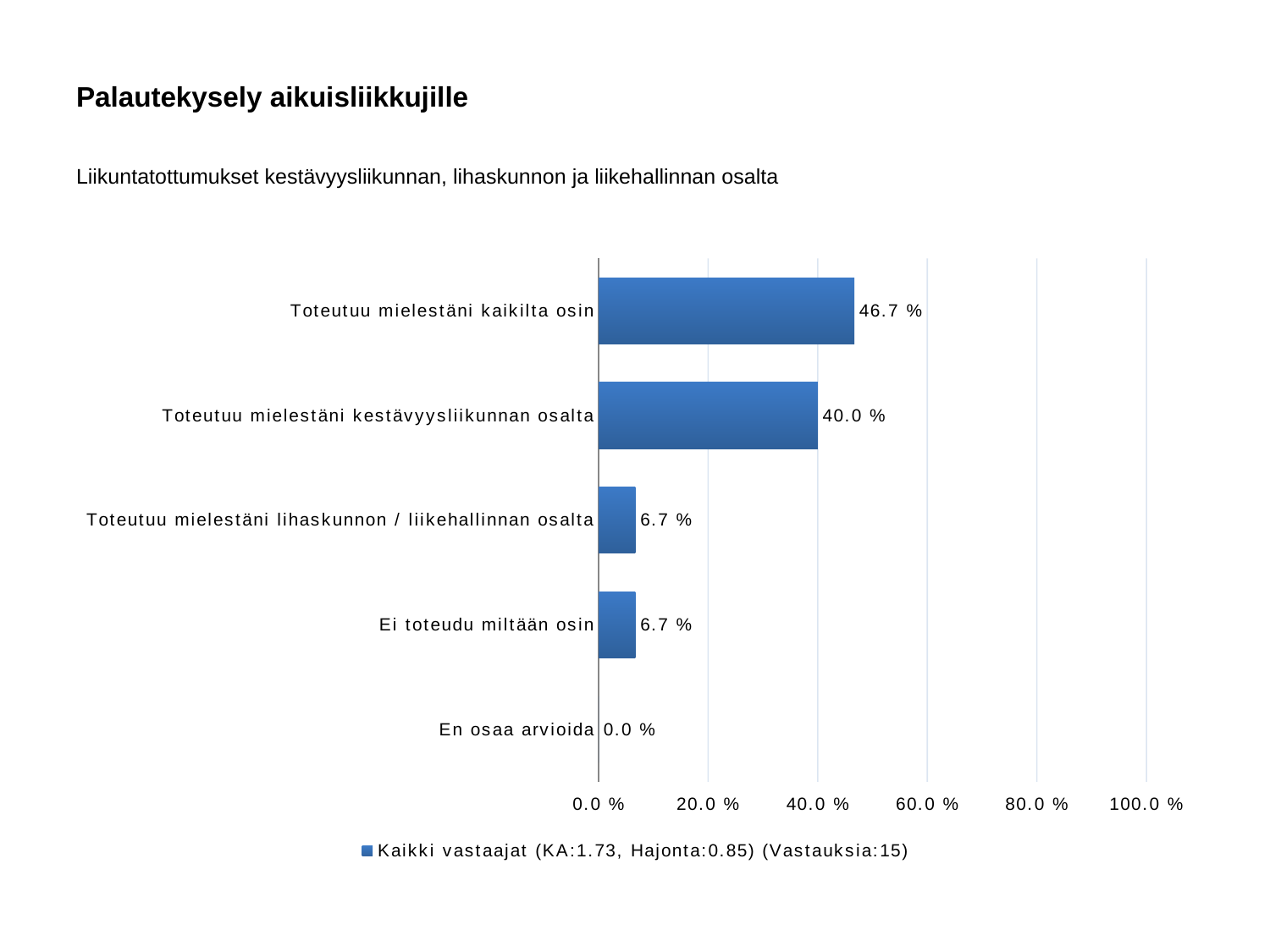
What is the value for "Toteutuu mielestäni kaikilta osin"? 46.7 % What is the value for "Ei toteudu miltään osin"? 6.7 % Is the value for "Toteutuu mielestäni kaikilta osin" greater or less than 40.0 %? greater Which category has the lowest value? En osaa arvioida What kind of chart is shown on the slide? Bar chart Which is larger: "Toteutuu mielestäni kestävyysliikunnan osalta" or "Toteutuu mielestäni lihaskunnon / liikehallinnan osalta"? Toteutuu mielestäni kestävyysliikunnan osalta What is the difference between "Toteutuu mielestäni kaikilta osin" and "Toteutuu mielestäni kestävyysliikunnan osalta"? 6.7 % What is the value for "En osaa arvioida"? 0.0 % How many responses (Vastauksia) does the legend entry report? 15 How many categories are shown in the chart? 5 Which category has the highest value? Toteutuu mielestäni kaikilta osin What is the value for "Toteutuu mielestäni kestävyysliikunnan osalta"? 40.0 %